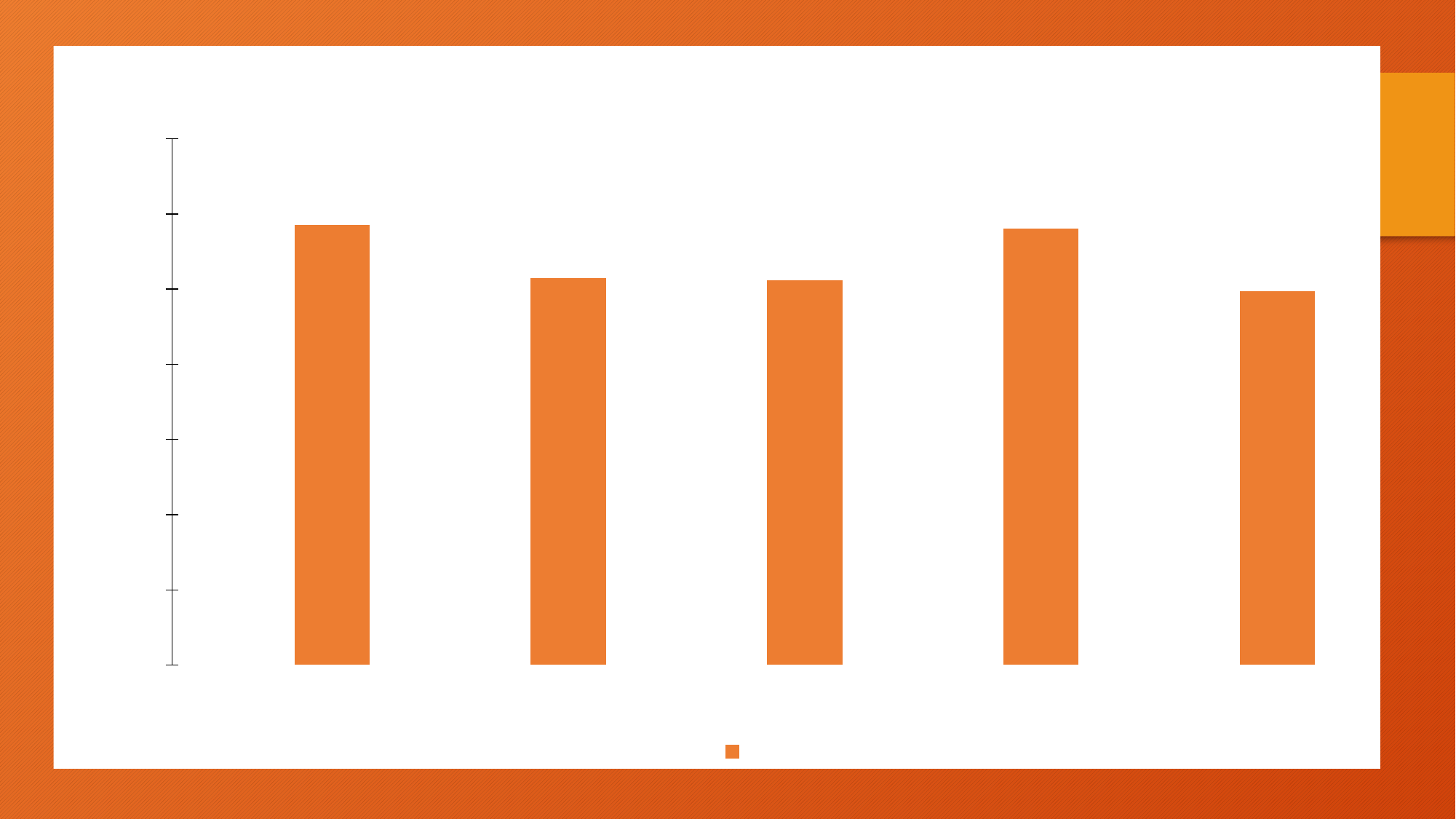
Which is taller, the first bar from the left or the fifth bar from the left? the first bar How many bars are plotted in the chart? 5 What colour are the bars in the chart? orange How many series does the legend list? 1 Which is taller, the fourth bar from the left or the fifth bar from the left? the fourth bar Which is taller, the first bar from the left or the second bar from the left? the first bar What kind of chart is shown on the slide? bar chart Are the bars in the chart vertical or horizontal? vertical